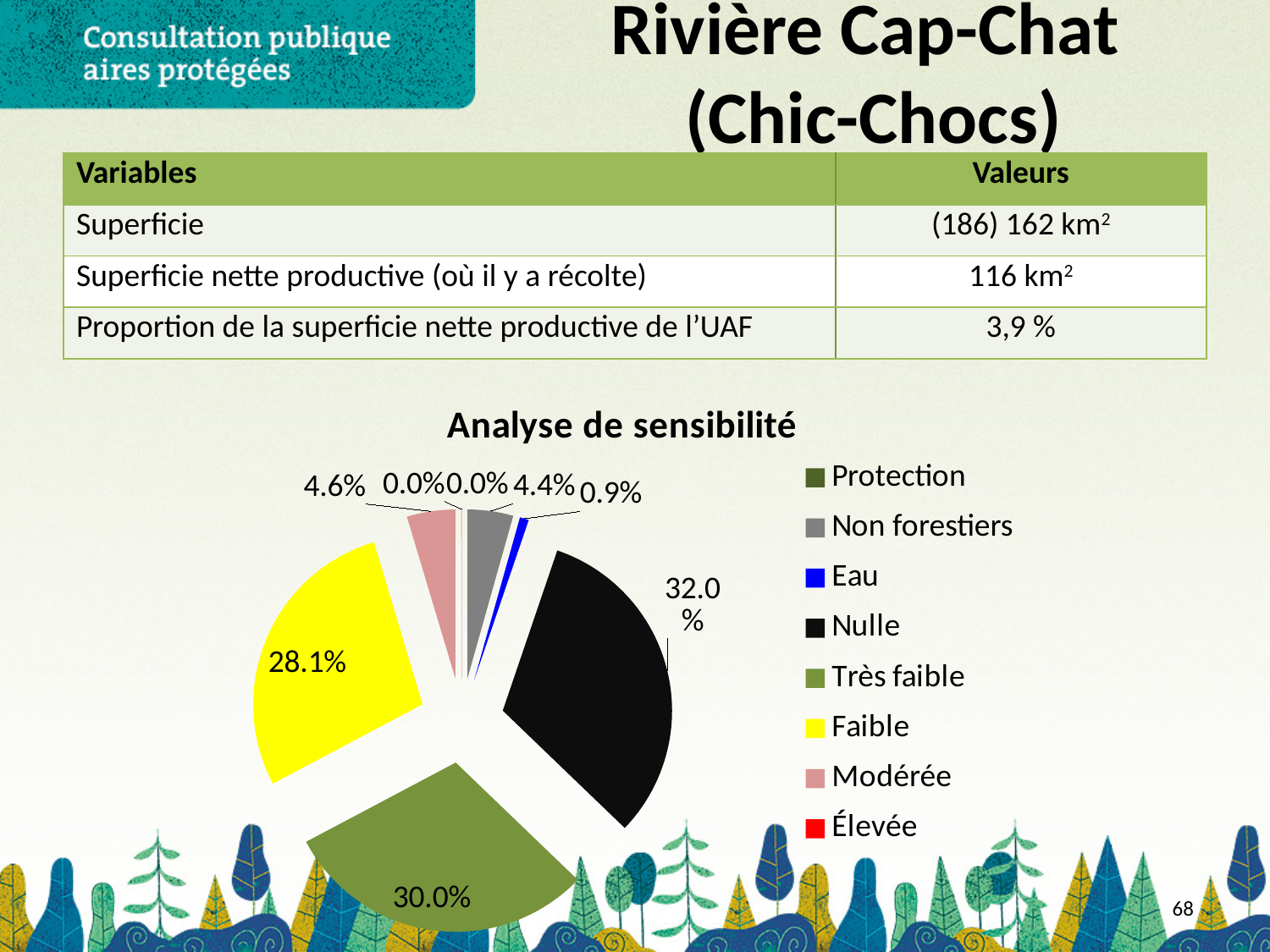
In the "Analyse de sensibilité" pie chart, what is the share for Faible? 28.1% In the "Analyse de sensibilité" pie chart, what is the difference between the shares for Nulle and Faible? 3.9% In the "Analyse de sensibilité" pie chart, what is the share for Très faible? 30.0% In the "Analyse de sensibilité" pie chart, what is the share for Nulle? 32.0% In the "Analyse de sensibilité" pie chart, what is the share for Eau? 0.9% In the "Analyse de sensibilité" pie chart, what is the share for Modérée? 4.6% What is the title of the pie chart on the slide? Analyse de sensibilité In the "Analyse de sensibilité" pie chart, which is larger, the share for Modérée or the share for Non forestiers? Modérée In the "Analyse de sensibilité" pie chart, what colour is the Faible slice? yellow What kind of chart is shown under the title "Analyse de sensibilité"? pie chart How many categories does the legend of the "Analyse de sensibilité" pie chart list? 8 In the "Analyse de sensibilité" pie chart, which category has the largest share? Nulle